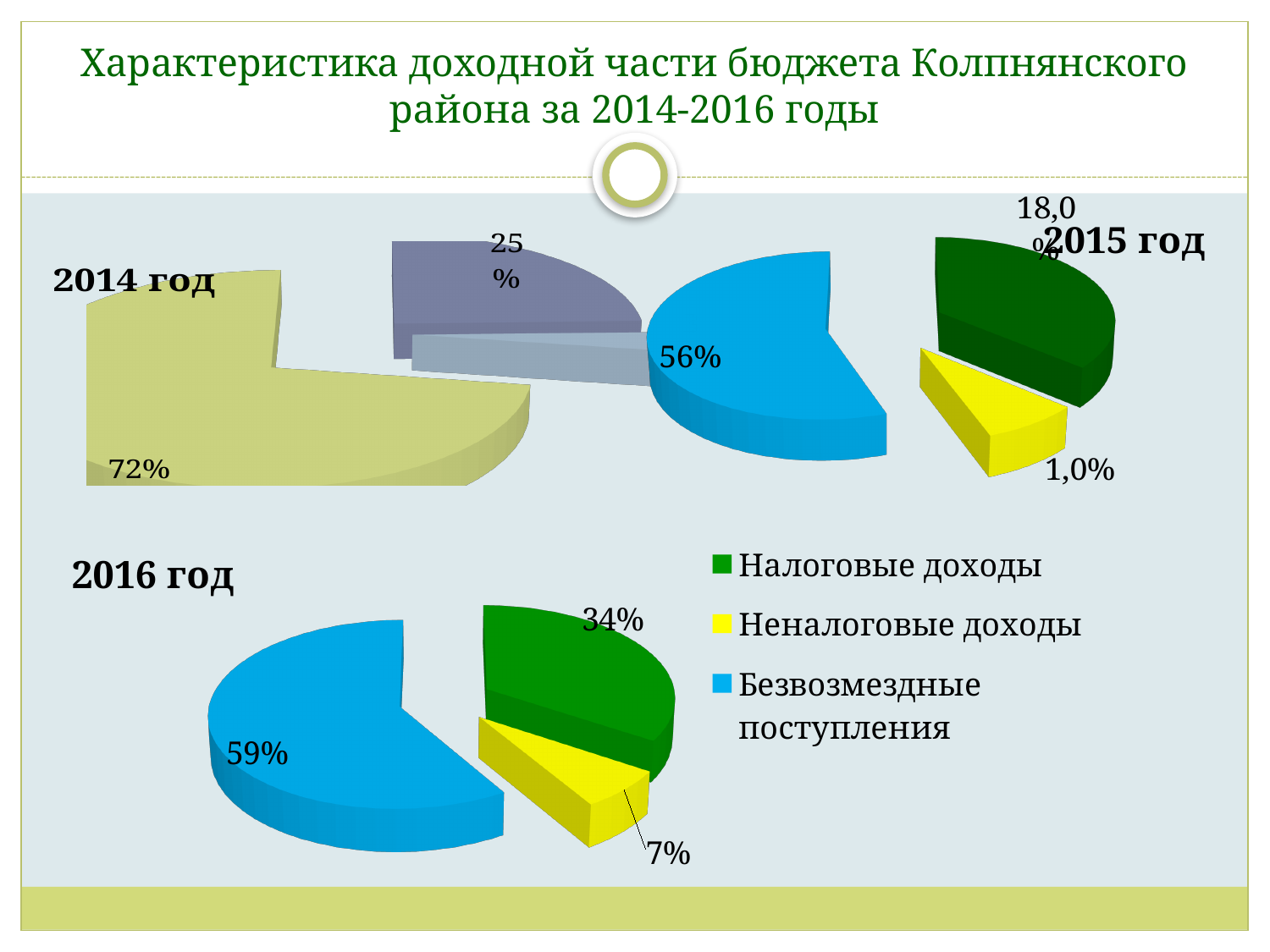
In the 2014 год chart, what is the value labelled on the largest slice? 72% In the 2015 год chart, what share is labelled for Безвозмездные поступления (blue slice)? 56% In the 2016 год chart, which category has the largest slice? Безвозмездные поступления How many categories does the legend list? 3 How many pie charts are on the slide? 3 In the 2015 год chart, which category has the smallest slice? Неналоговые доходы In the 2016 год chart, what share is labelled for Налоговые доходы (green slice)? 34% What kind of charts are shown on the slide? Pie charts In the 2015 год chart, what share is labelled for Неналоговые доходы (yellow slice)? 1,0% In the 2016 год chart, what share is labelled for Неналоговые доходы (yellow slice)? 7% In the 2016 год chart, what share is labelled for Безвозмездные поступления (blue slice)? 59% In the 2016 год chart, by how many percentage points does Безвозмездные поступления exceed Налоговые доходы? 25